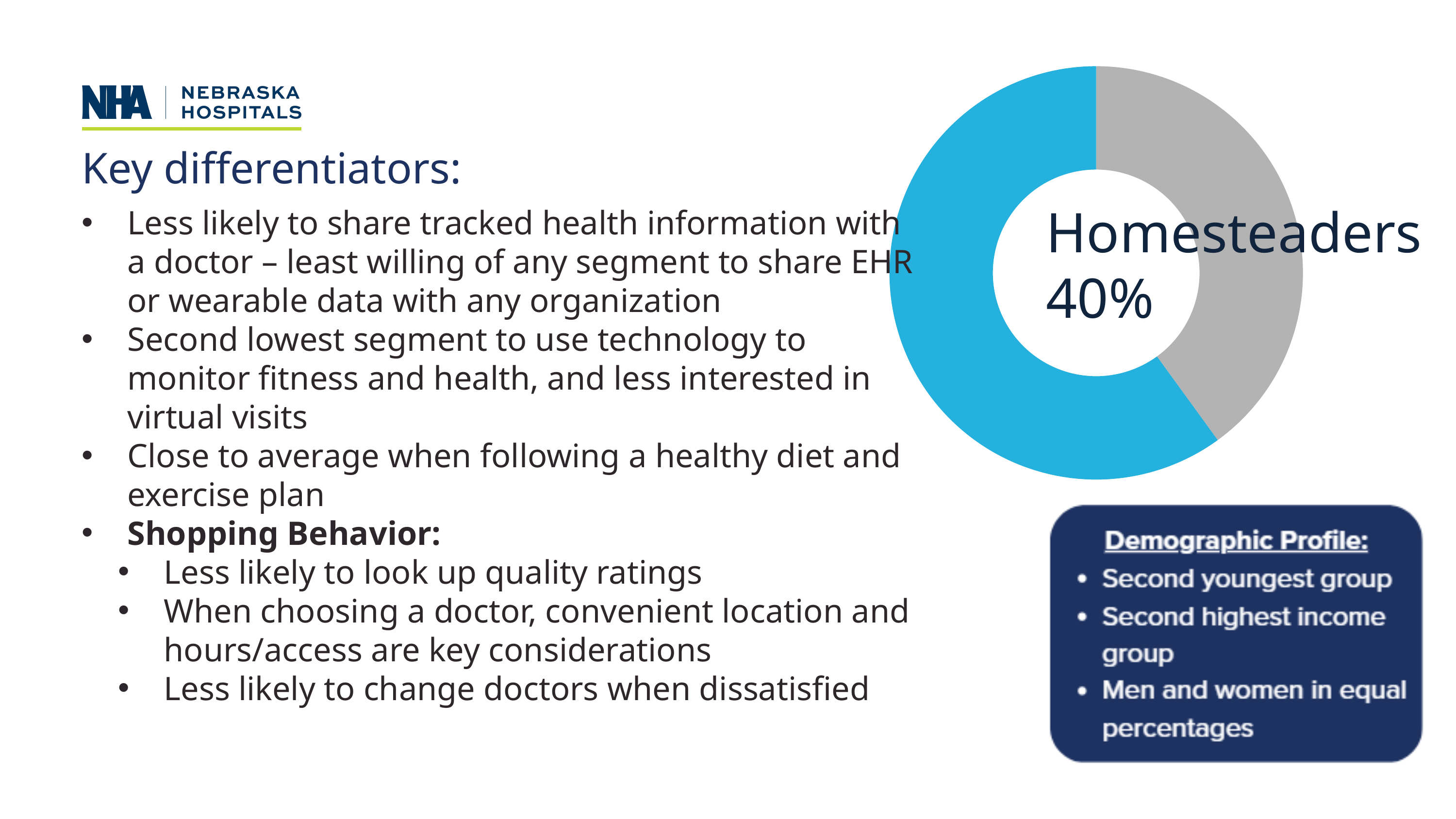
What percentage is printed in the centre of the donut chart? 40% Which slice of the donut chart is larger, the blue one or the grey one? Blue Which slice of the donut chart is the smallest? The grey slice What kind of chart is shown on the right of the slide? Donut (pie) chart What two colours are used for the slices of the donut chart? Blue and grey What segment name is printed in the centre of the donut chart? Homesteaders Is the grey slice of the donut chart greater or less than 50% of the ring? less Is the blue slice of the donut chart greater or less than 50% of the ring? greater How many slices does the donut chart have? 2